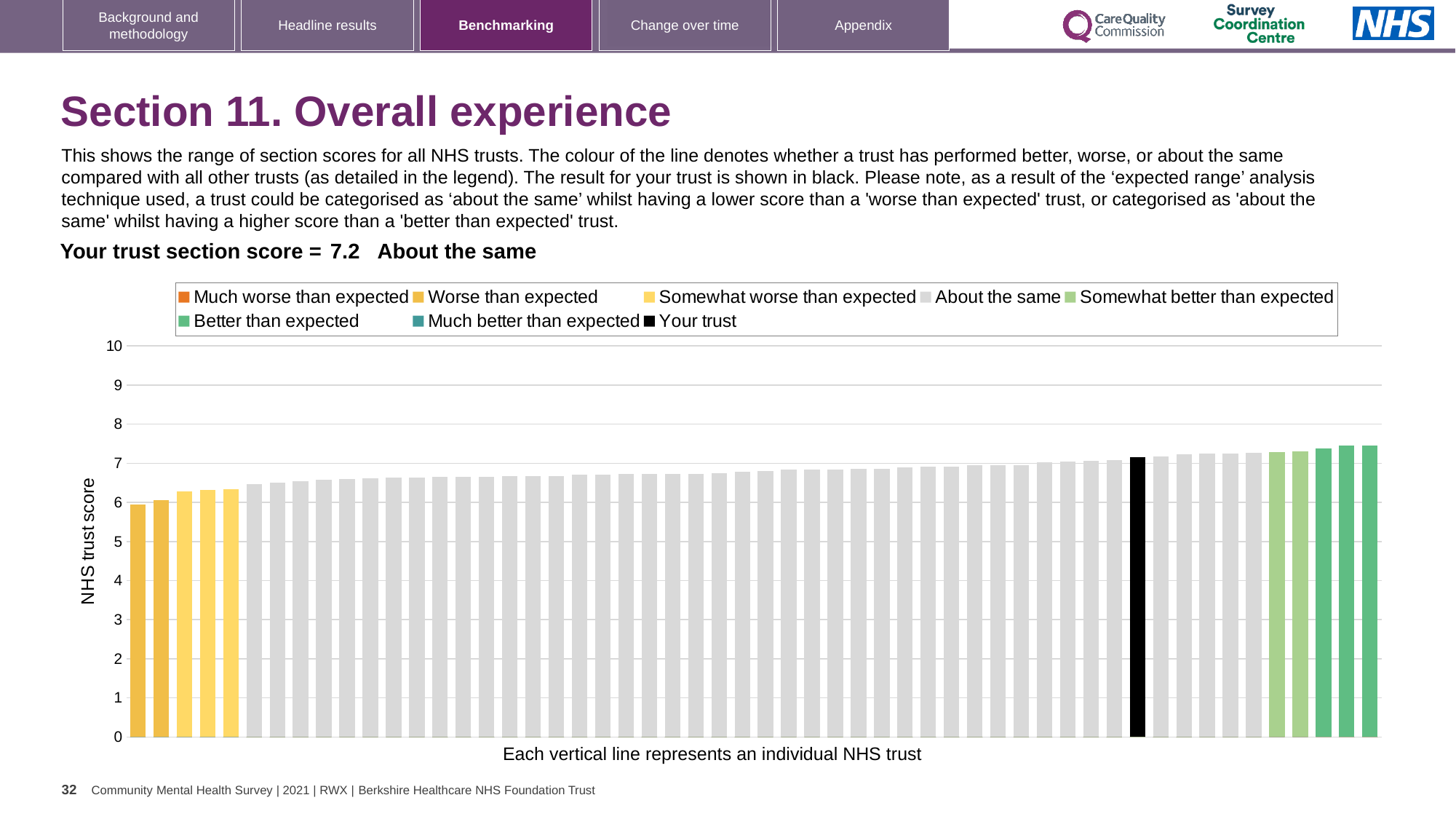
What is the label on the vertical axis of the chart? NHS trust score How many bars are coloured in the 'Worse than expected' (darker yellow) colour? 2 Do the bar values rise or fall from left to right along the x axis? rise What type of chart is shown on the slide? bar chart How many entries does the chart legend list? 8 What colour is used for the 'Your trust' bar? black Which benchmarking category is your trust placed in for this section? About the same Is the value of the leftmost (lowest) bar greater or less than 7? less What is the section score for your trust shown on the slide? 7.2 Is the value of the rightmost (highest) bar greater or less than 8? less Is the value of the black 'Your trust' bar greater or less than 7? greater Is your trust's bar higher or lower than the tallest bar in the chart? lower